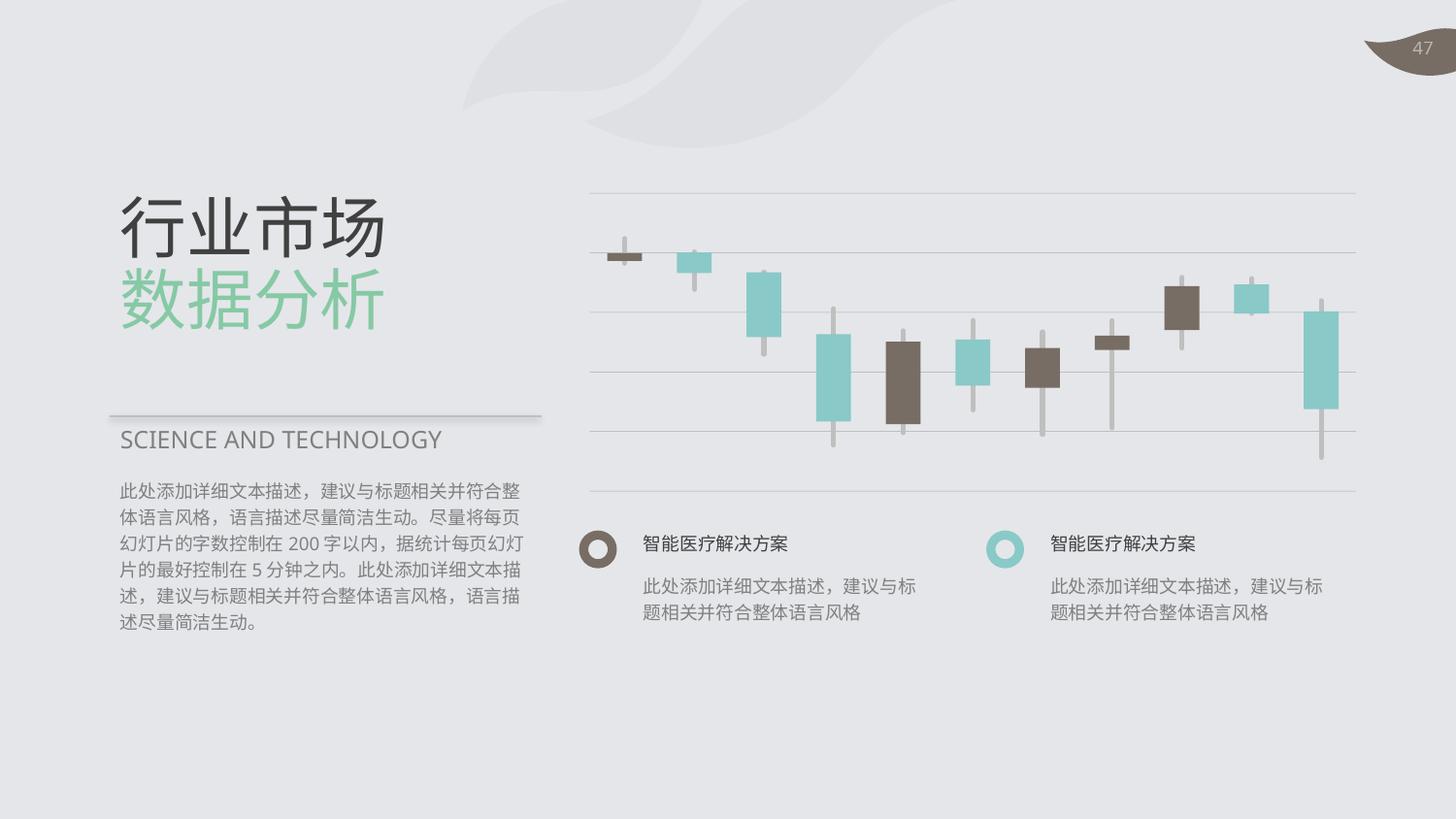
How many different colours are used for the candlestick bodies in the chart? 2 What kind of chart is shown on the slide? candlestick chart What colour is the body of the last (rightmost) candlestick in the chart? teal How many candlesticks are plotted in the chart? 11 Does the chart display a legend? No What colour is the body of the first (leftmost) candlestick in the chart? brown How many candlesticks in the chart have a brown body? 5 How many candlesticks in the chart have a teal body? 6